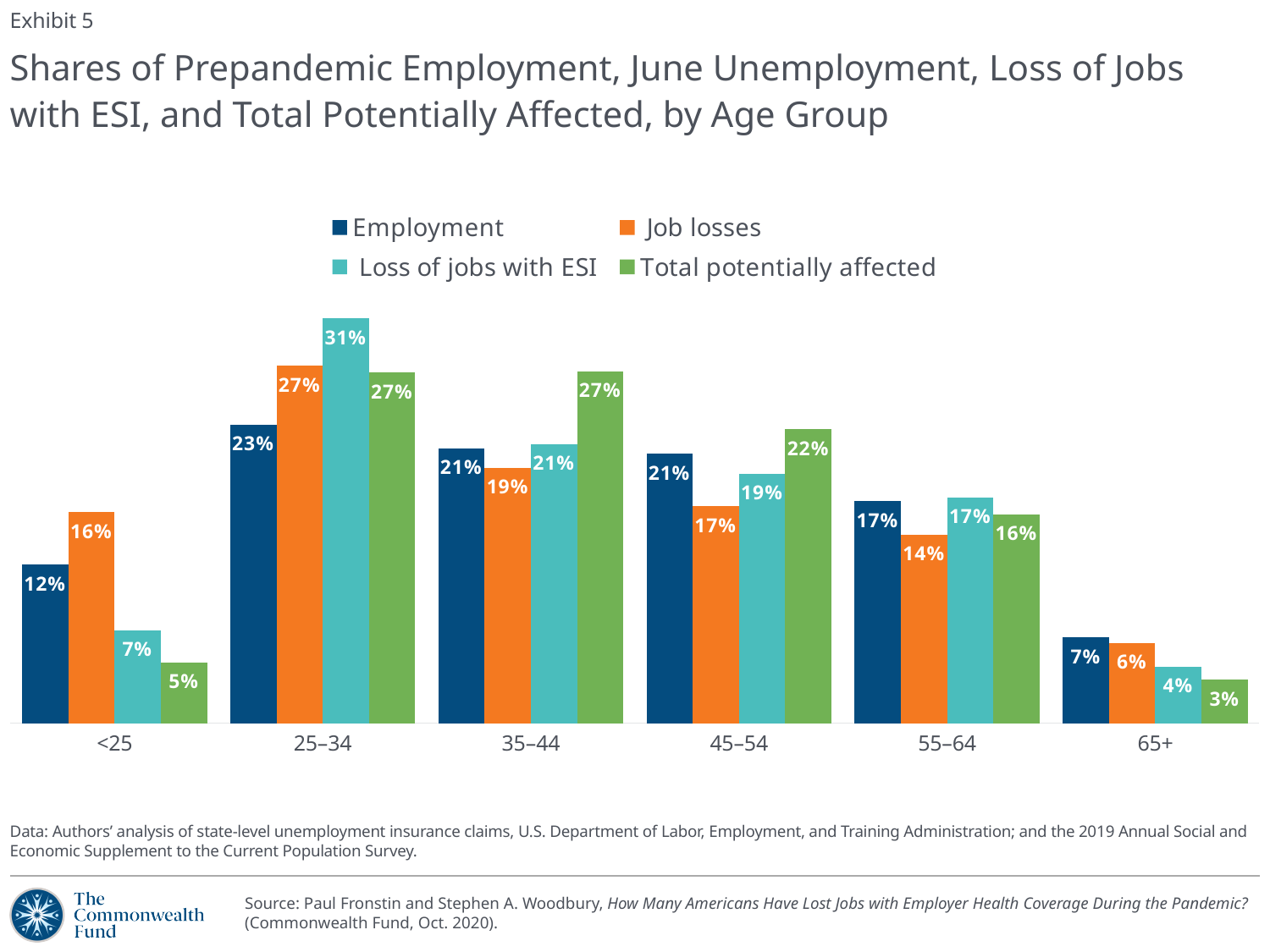
How many age groups are shown on the x axis? 6 What kind of chart is shown on the slide? Bar chart How many series does the legend list? 4 What is the Total potentially affected value for the 45–54 age group? 22% What is the Employment share for the 25–34 age group? 23% Which age group has the lowest Total potentially affected value? 65+ Which age group has the highest Loss of jobs with ESI value? 25–34 What is the Loss of jobs with ESI value for the <25 age group? 7% What is the difference between the Job losses and Employment values for the <25 age group? 4% What is the Job losses value for the 55–64 age group? 14% Which is larger for the 35–44 age group: Employment or Total potentially affected? Total potentially affected Which series is shown in orange in the legend? Job losses